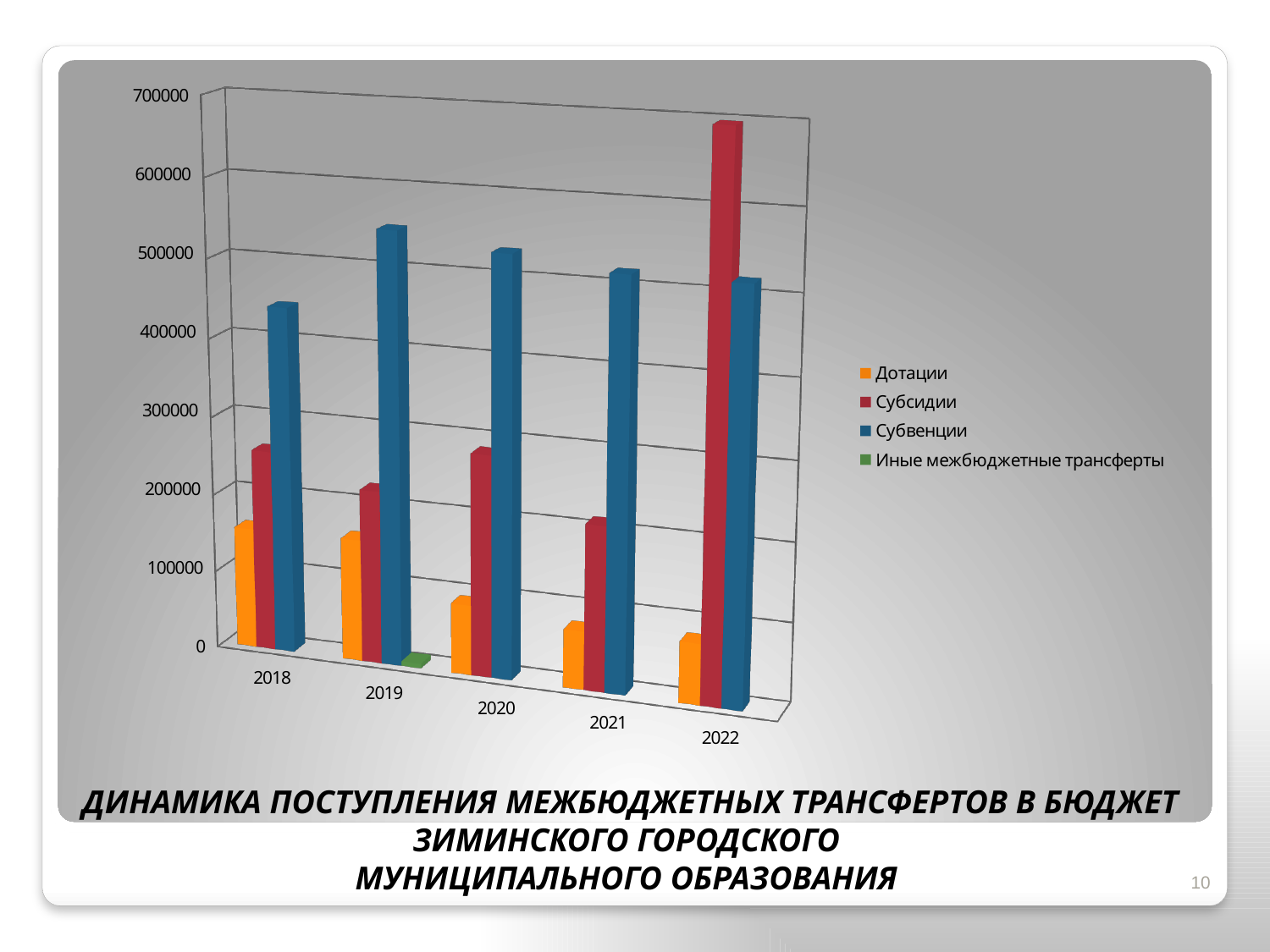
In which year is the value for Дотации the lowest? 2021 Do the values for Дотации rise or fall from 2018 to 2022? Fall What kind of chart is shown on the slide? Bar chart Which series has the tallest bar in the whole chart? Субсидии In which year is the value for Субвенции the highest? 2019 Is the value for Дотации in 2022 greater or less than 100000? less Is the value for Дотации in 2018 greater or less than 100000? greater Is the value for Субсидии in 2022 greater or less than 600000? greater How many series does the chart legend list? 4 In 2022, which is larger: Субсидии or Субвенции? Субсидии In which year does the series Иные межбюджетные трансферты have a visible bar? 2019 How many years are shown on the x axis of the chart? 5